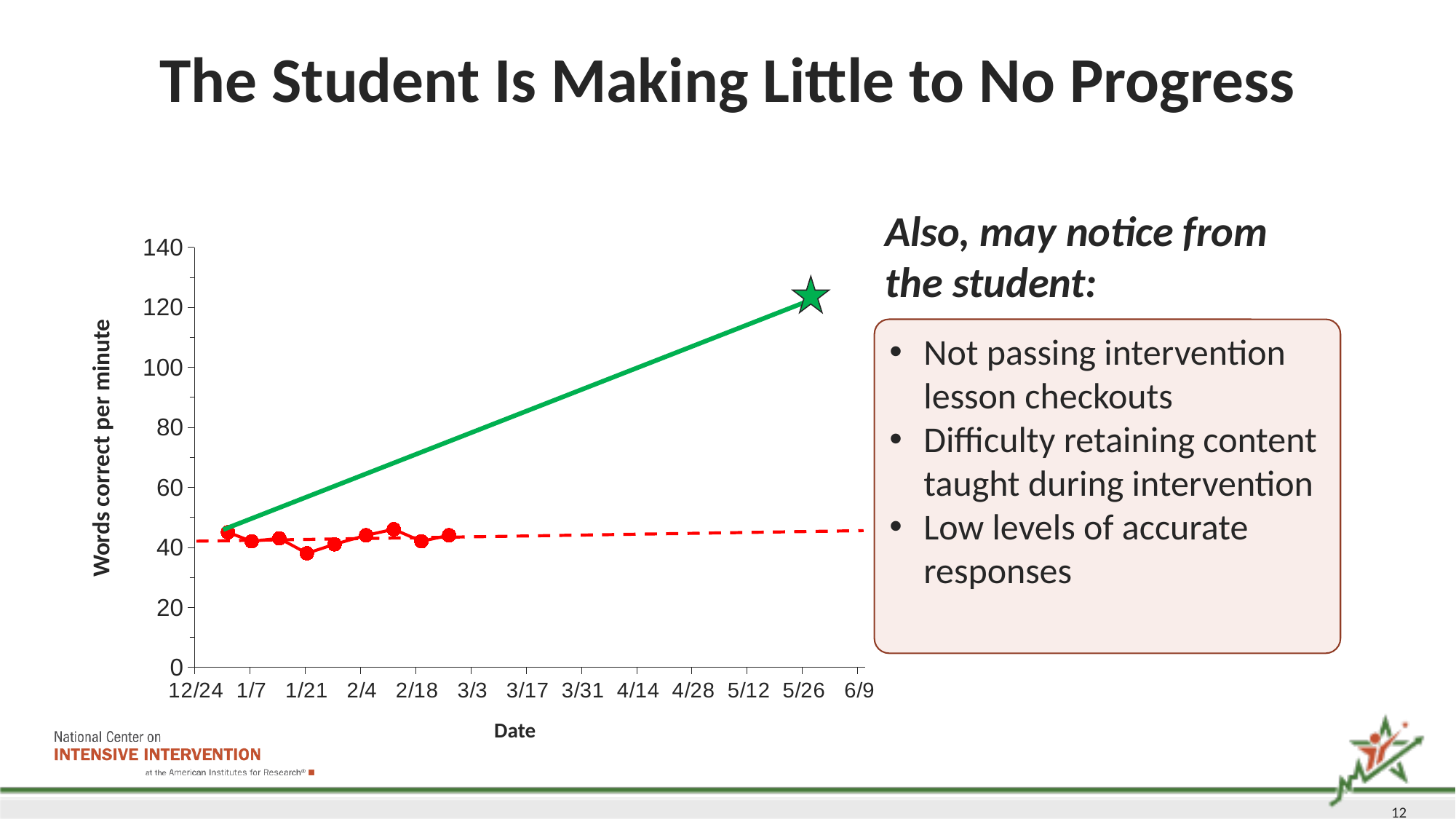
What is the highest value shown on the vertical axis? 140 Is the first red data point (near 1/1) greater or less than 60? less Is the red data point near 2/11 greater or less than 40? greater What kind of chart is shown on the slide? Line chart What is the label on the vertical axis of the chart? Words correct per minute Is the value at the green star (the goal point) greater or less than 100? greater Do the red data points show a clear rising trend, a clear falling trend, or stay roughly flat across the dates? Roughly flat What is the label on the horizontal axis of the chart? Date How many red data points are plotted on the chart? 9 Does the green goal line rise or fall from left to right? Rise Which is larger: the value at the green star or the value of the last red data point (near 2/25)? The green star